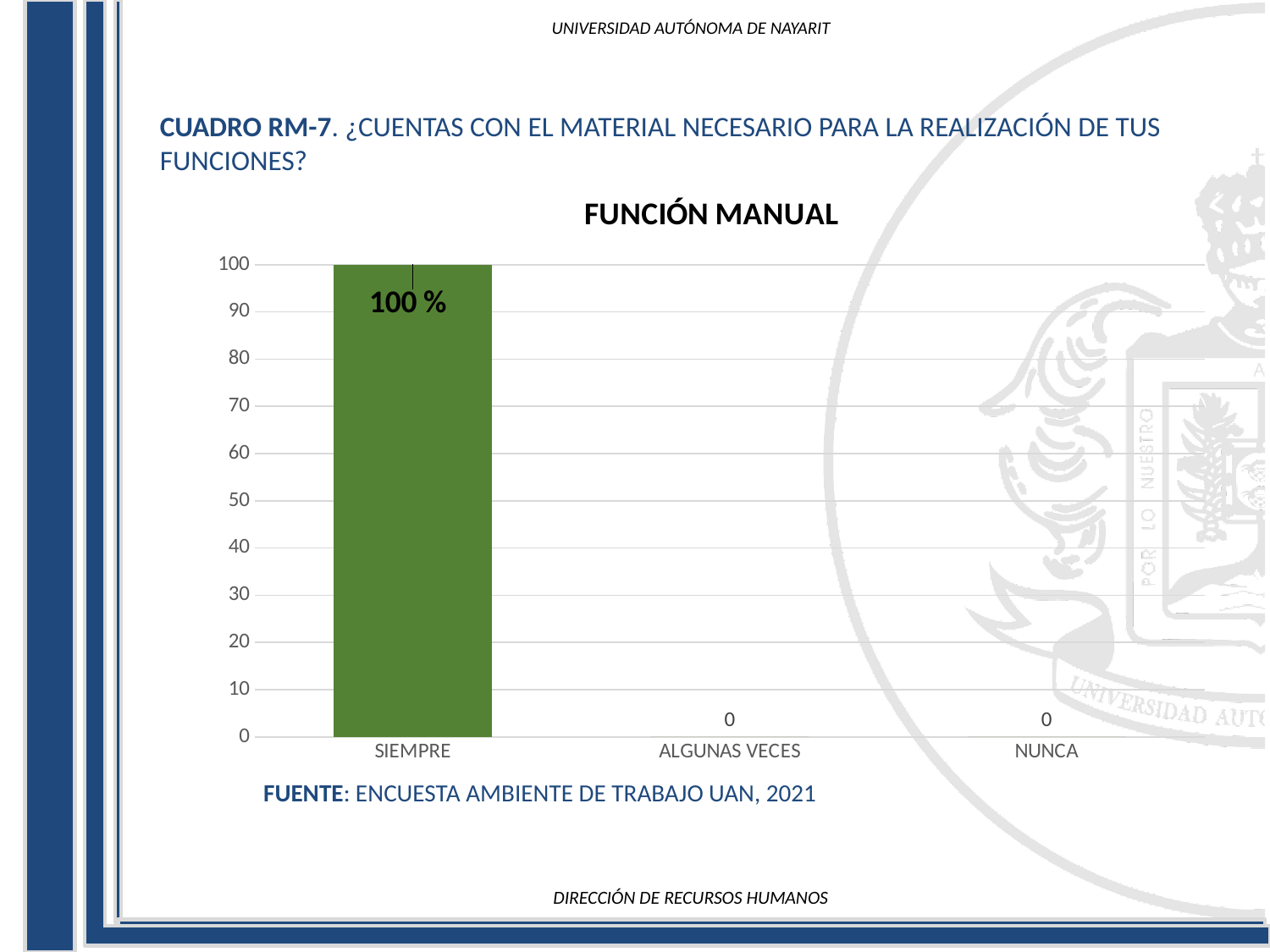
What is the title of the chart? FUNCIÓN MANUAL What is the value for NUNCA? 0 Is the value for SIEMPRE greater or less than 50? greater Which category has the highest value? SIEMPRE What is the value for ALGUNAS VECES? 0 Which is larger, the value for SIEMPRE or the value for NUNCA? SIEMPRE What kind of chart is shown? bar chart What colour is the bar for SIEMPRE? green How many categories are shown on the x axis? 3 What is the value for SIEMPRE? 100 % Do the values rise or fall from SIEMPRE to NUNCA along the x axis? fall What is the difference between the value for SIEMPRE and the value for ALGUNAS VECES? 100